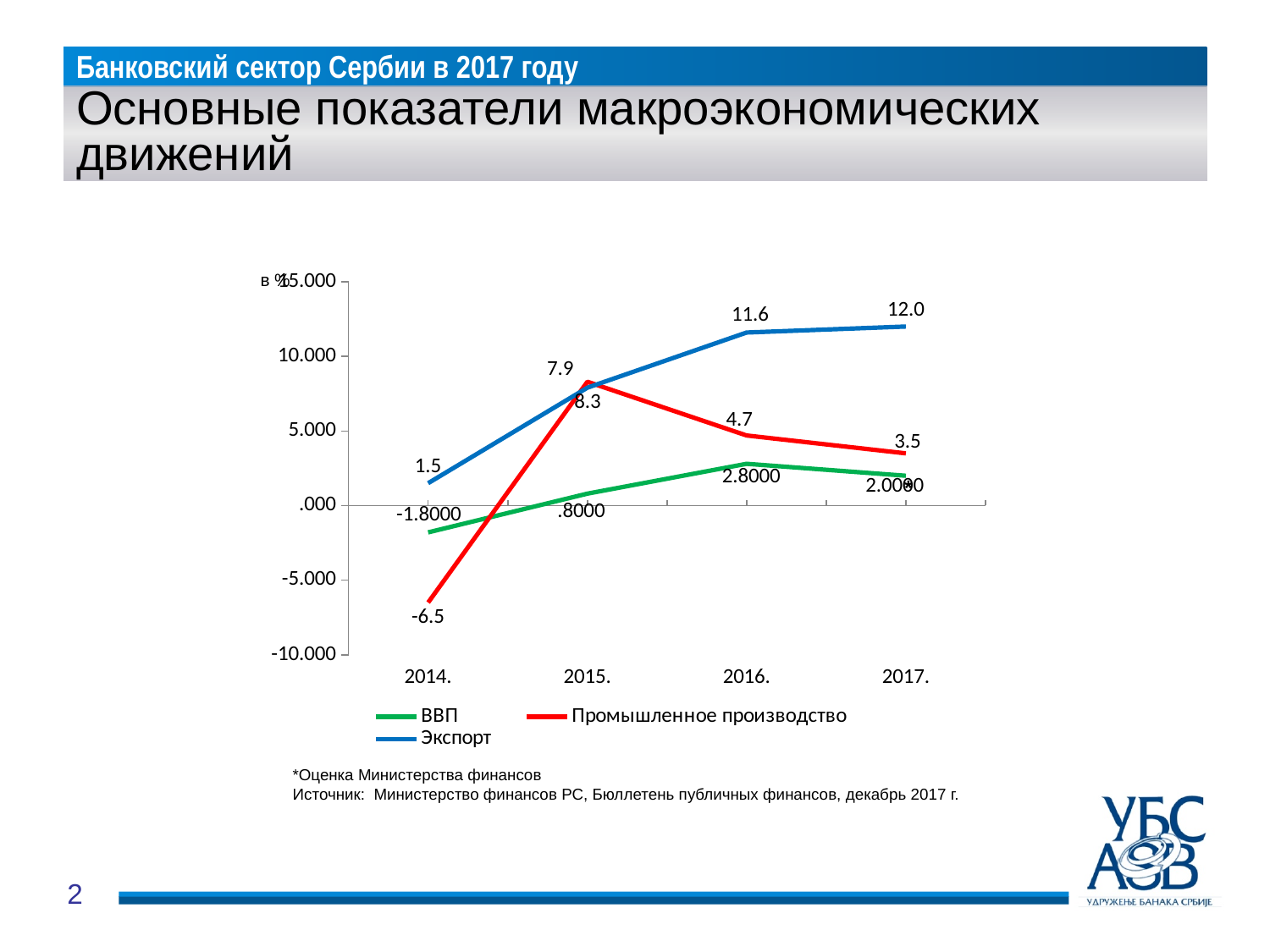
What is the value of Экспорт in 2016? 11.6 Does the Экспорт series rise or fall from 2014 to 2017? Rise What is the difference between Экспорт in 2017 and in 2016? 0.4 What is the value of Промышленное производство in 2014? -6.5 In which year is Экспорт highest? 2017. In which year is Промышленное производство lowest? 2014. What is the value of ВВП in 2016? 2.8000 How many series does the legend list? 3 What kind of chart is shown on the slide? Line chart How many years are shown on the x axis? 4 In 2015, which is larger: Промышленное производство or Экспорт? Промышленное производство What is the value of ВВП in 2014? -1.8000